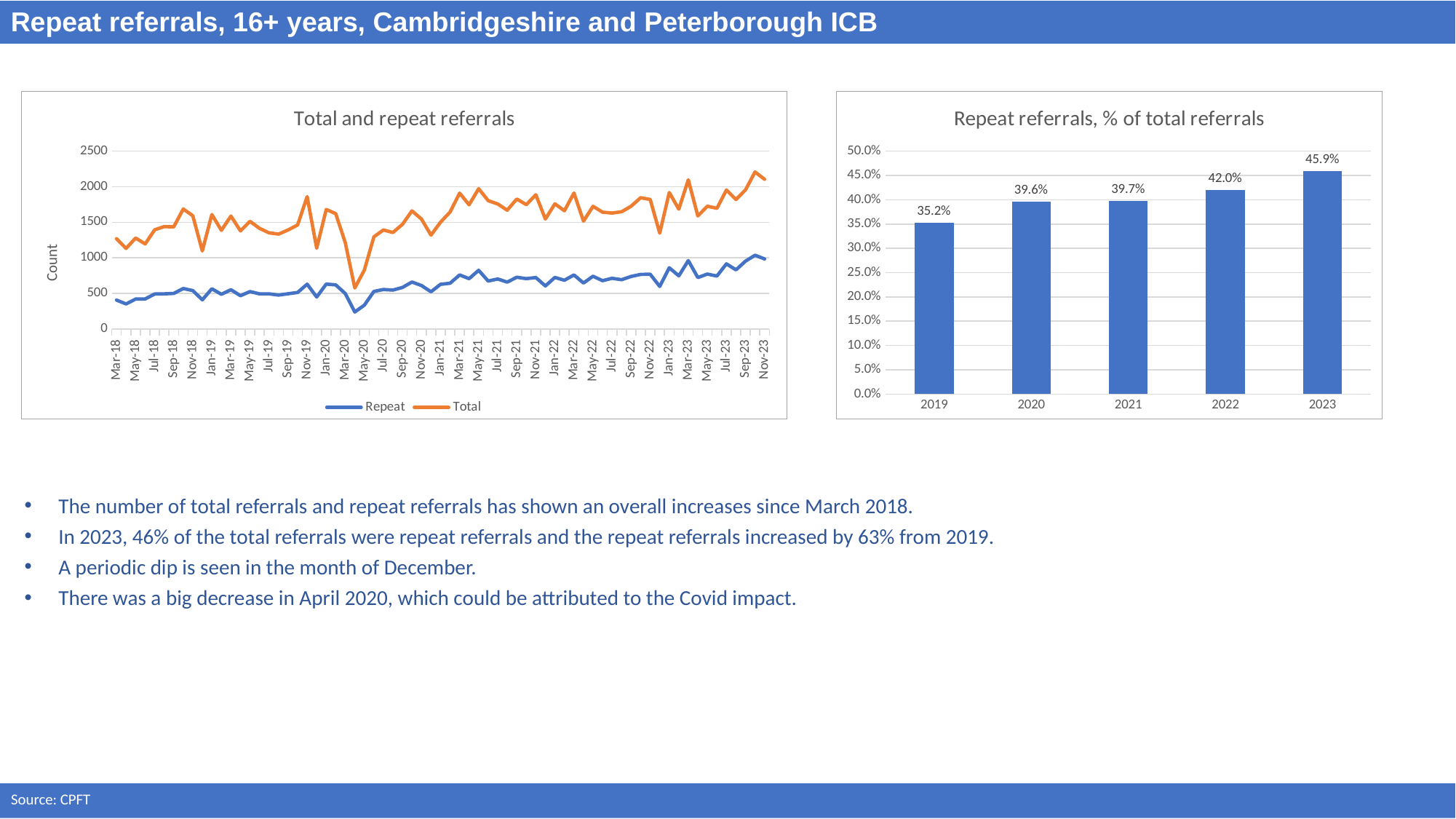
In the chart 'Repeat referrals, % of total referrals', which year has the highest value? 2023 In the chart 'Repeat referrals, % of total referrals', what is the value for 2023? 45.9% In the chart 'Repeat referrals, % of total referrals', what is the value for 2019? 35.2% In the chart 'Repeat referrals, % of total referrals', which year has the lowest value? 2019 In the chart 'Repeat referrals, % of total referrals', how many years are shown? 5 In the chart 'Total and repeat referrals', is the Repeat value for Mar-18 greater or less than 500? less In the chart 'Repeat referrals, % of total referrals', what is the difference between the 2023 and 2019 values? 10.7% In the chart 'Total and repeat referrals', is the Total value for Nov-23 greater or less than 2000? greater In the chart 'Repeat referrals, % of total referrals', what is the value for 2021? 39.7% In the chart 'Repeat referrals, % of total referrals', do the values rise or fall from 2019 to 2023? rise How many series does the legend of the chart 'Total and repeat referrals' list? 2 What kind of chart is 'Total and repeat referrals'? line chart